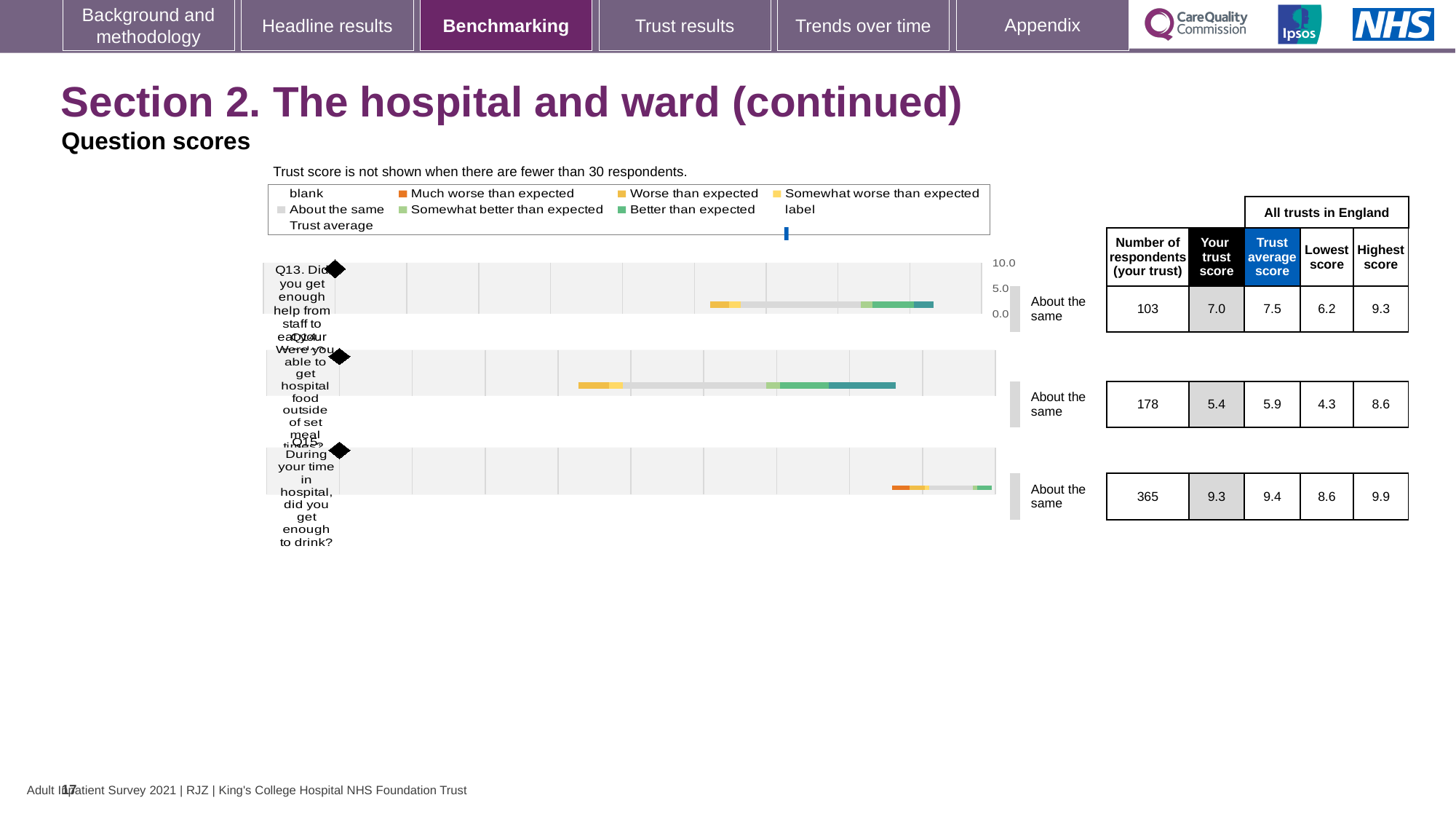
What benchmark category is shown next to each of the three questions? About the same How many respondents answered Q15 (During your time in hospital, did you get enough to drink)? 365 What is the difference between the trust average score and the trust score for Q13? 0.5 Which of the three questions shown has the highest trust score? Q15 What is the highest score across all trusts in England for Q14? 8.6 What is the trust average score for Q14 (Were you able to get hospital food outside of set meal times)? 5.9 What kind of chart is used to show the question scores? bar chart What is the lowest score across all trusts in England for Q13? 6.2 Is the trust score for Q15 larger or smaller than the trust score for Q13? larger Which of the three questions shown has the lowest trust score? Q14 How many questions are plotted on the chart? 3 What is the trust score for Q13 (Did you get enough help from staff to eat your meals)? 7.0